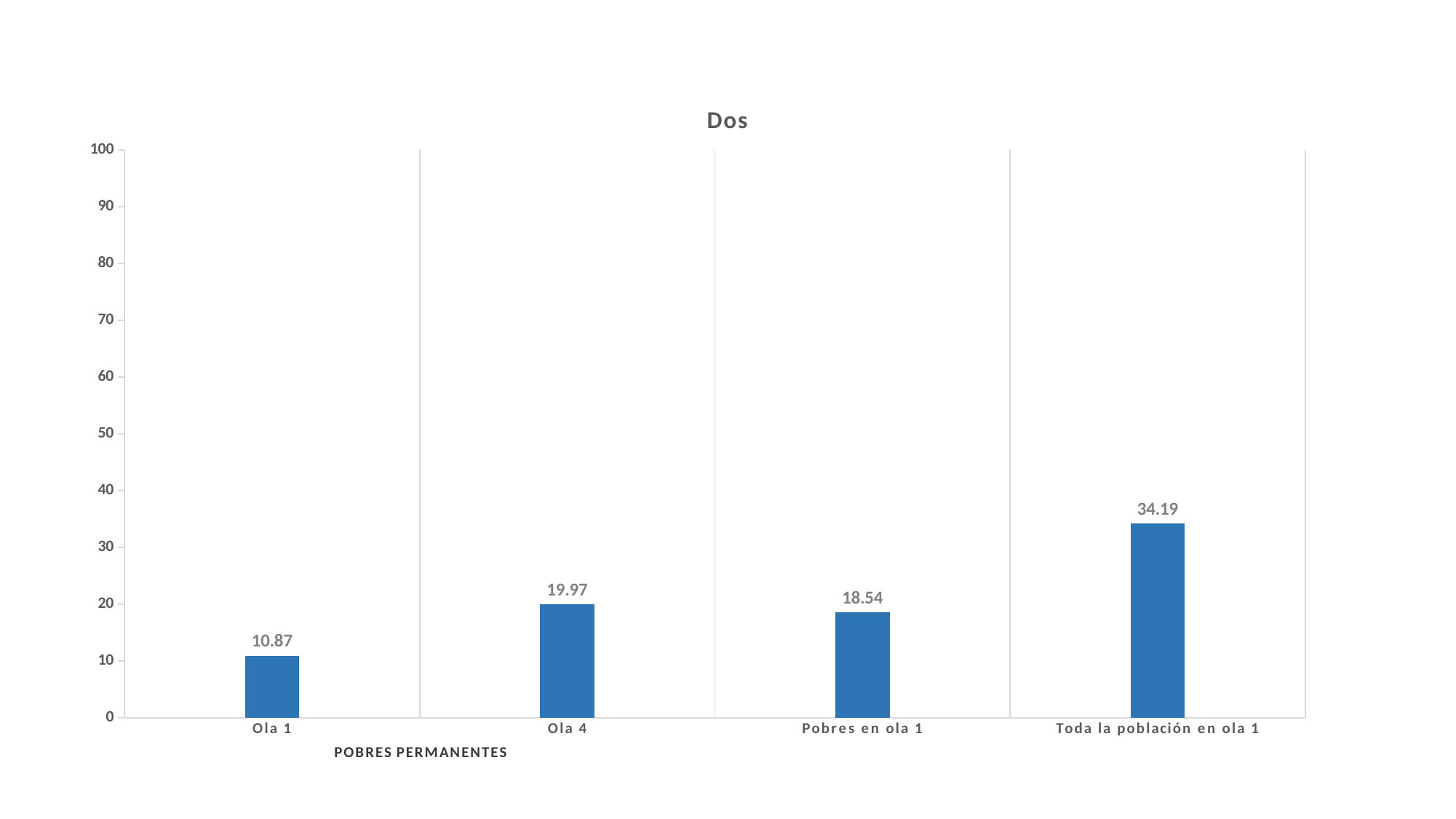
Is the value for Toda la población en ola 1 greater or less than 30? greater What is the difference between the values for Toda la población en ola 1 and Ola 1? 23.32 What is the value for Ola 4? 19.97 Which category has the lowest value? Ola 1 What is the difference between the values for Ola 4 and Pobres en ola 1? 1.43 What is the value for Pobres en ola 1? 18.54 What is the value for Toda la población en ola 1? 34.19 How many categories are shown on the x axis? 4 What is the value for Ola 1? 10.87 What is the title of the chart? Dos Which category has the highest value? Toda la población en ola 1 Which is larger, the value for Ola 4 or the value for Ola 1? Ola 4